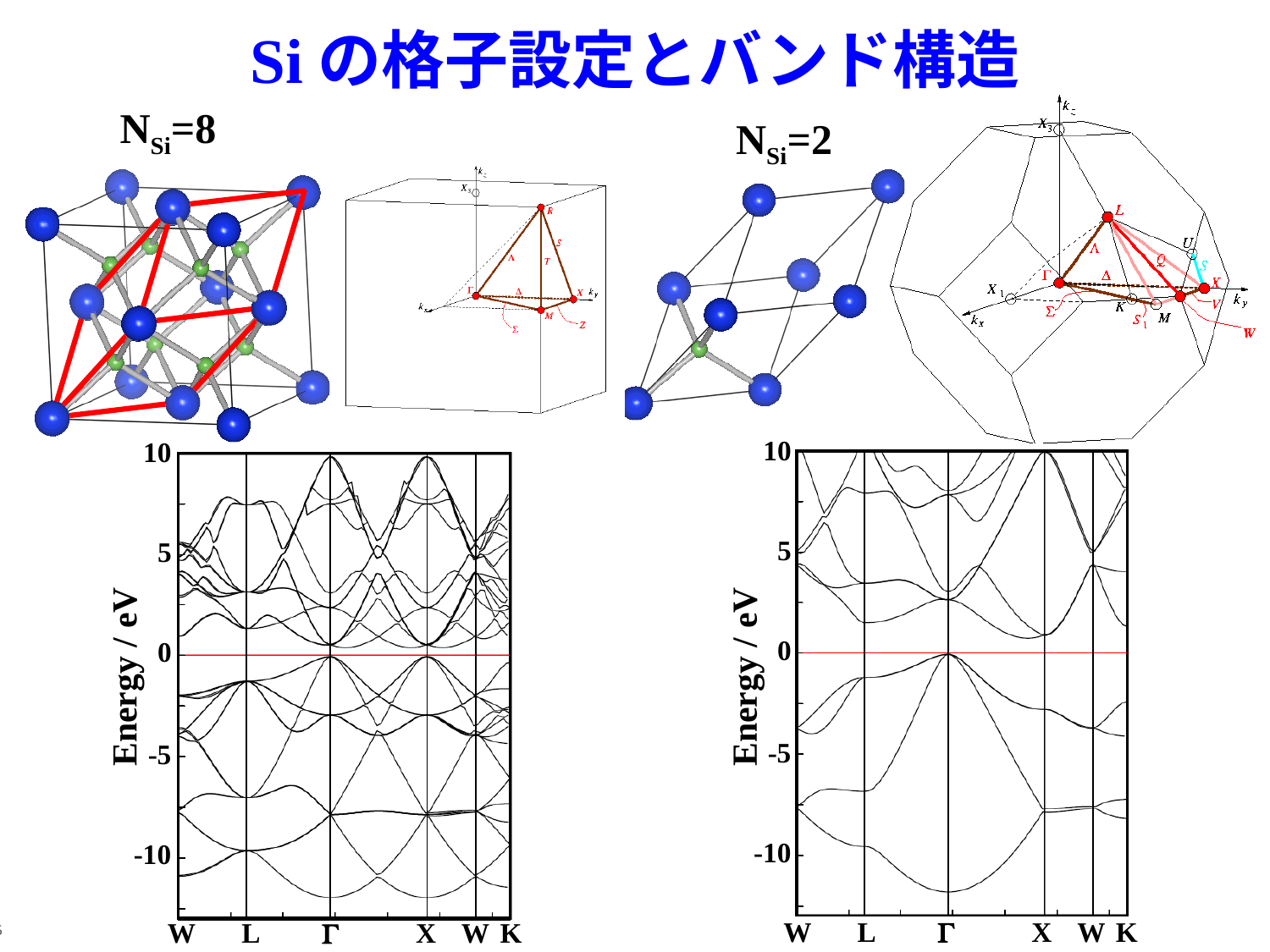
In the right band structure chart (N_Si=2), is the energy of the lowest band at Γ greater or less than -10? less In the right band structure chart (N_Si=2), is the energy of the lowest band at X greater or less than -10? greater In the right band structure chart (N_Si=2), how many high-symmetry point labels are shown along the x axis? 6 In the right band structure chart (N_Si=2), at what energy value is the horizontal red line drawn? 0 In the left band structure chart (N_Si=8), is the energy of the lowest band at X greater or less than -10? greater In the left band structure chart (N_Si=8), what is the label of the y axis? Energy / eV In the left band structure chart (N_Si=8), what is the lowest value shown on the y axis? -10 What kind of chart is the band structure plot on the left (N_Si=8)? line chart In the left band structure chart (N_Si=8), what are the labels along the x axis, from left to right? W, L, Γ, X, W, K In the right band structure chart (N_Si=2), what is the highest value shown on the y axis? 10 What kind of chart is the band structure plot on the right (N_Si=2)? line chart